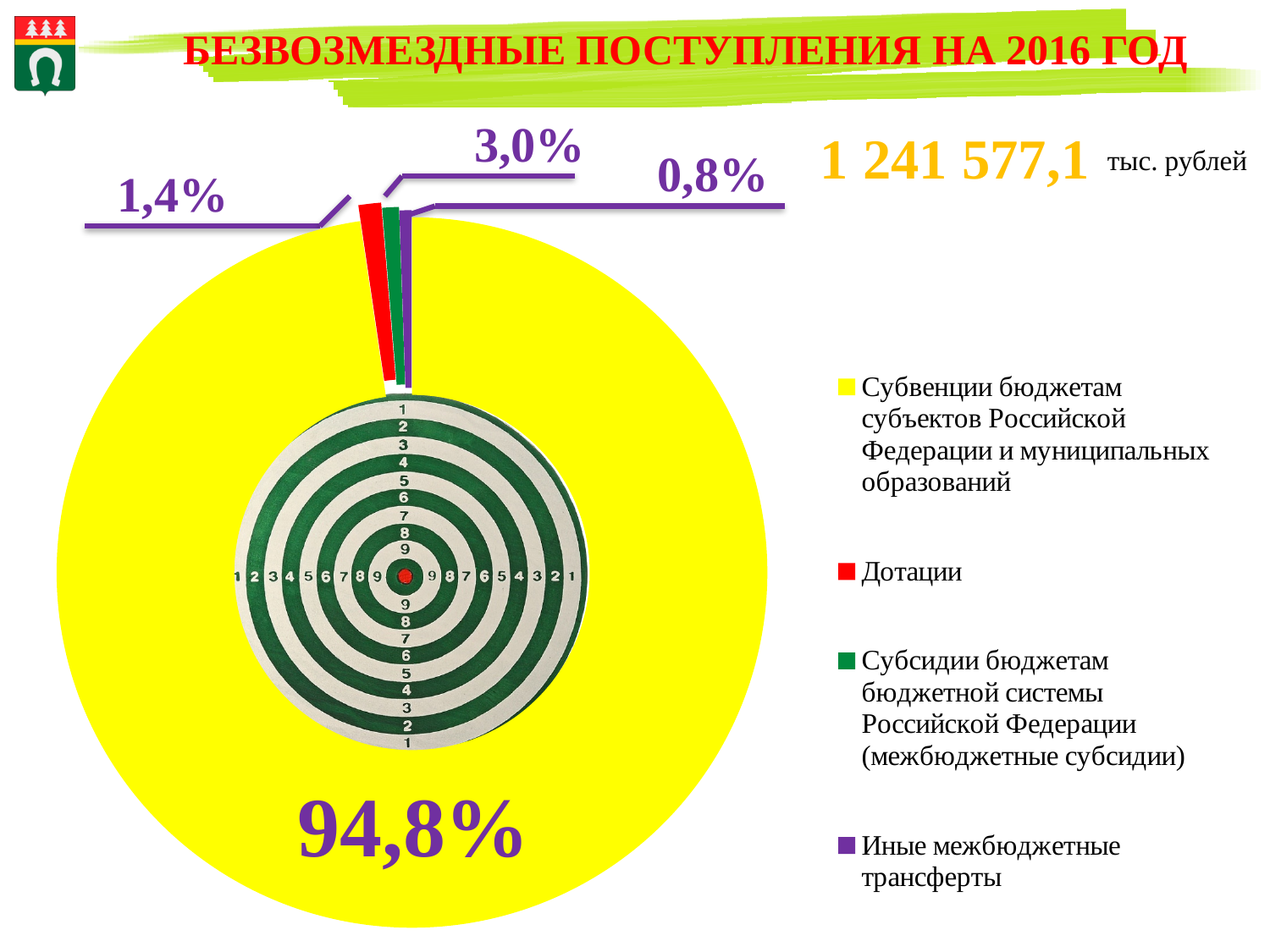
What colour is the slice for Дотации? red Which category has the largest slice of the pie? Субвенции бюджетам субъектов Российской Федерации и муниципальных образований How many slices does the pie chart have? 4 What share of the pie does the slice for Иные межбюджетные трансферты represent? 0,8% Which category has the smallest slice of the pie? Иные межбюджетные трансферты What kind of chart is shown on the slide? pie chart What total amount in тыс. рублей is shown on the slide for безвозмездные поступления на 2016 год? 1 241 577,1 Which is larger: the slice for Дотации or the slice for Субсидии бюджетам бюджетной системы Российской Федерации (межбюджетные субсидии)? Субсидии бюджетам бюджетной системы Российской Федерации (межбюджетные субсидии) What share of the pie does the slice for Субвенции бюджетам субъектов Российской Федерации и муниципальных образований represent? 94,8% What is the difference in percentage points between the slice for Субсидии бюджетам бюджетной системы Российской Федерации (межбюджетные субсидии) and the slice for Дотации? 1,6 What share of the pie does the slice for Субсидии бюджетам бюджетной системы Российской Федерации (межбюджетные субсидии) represent? 3,0%